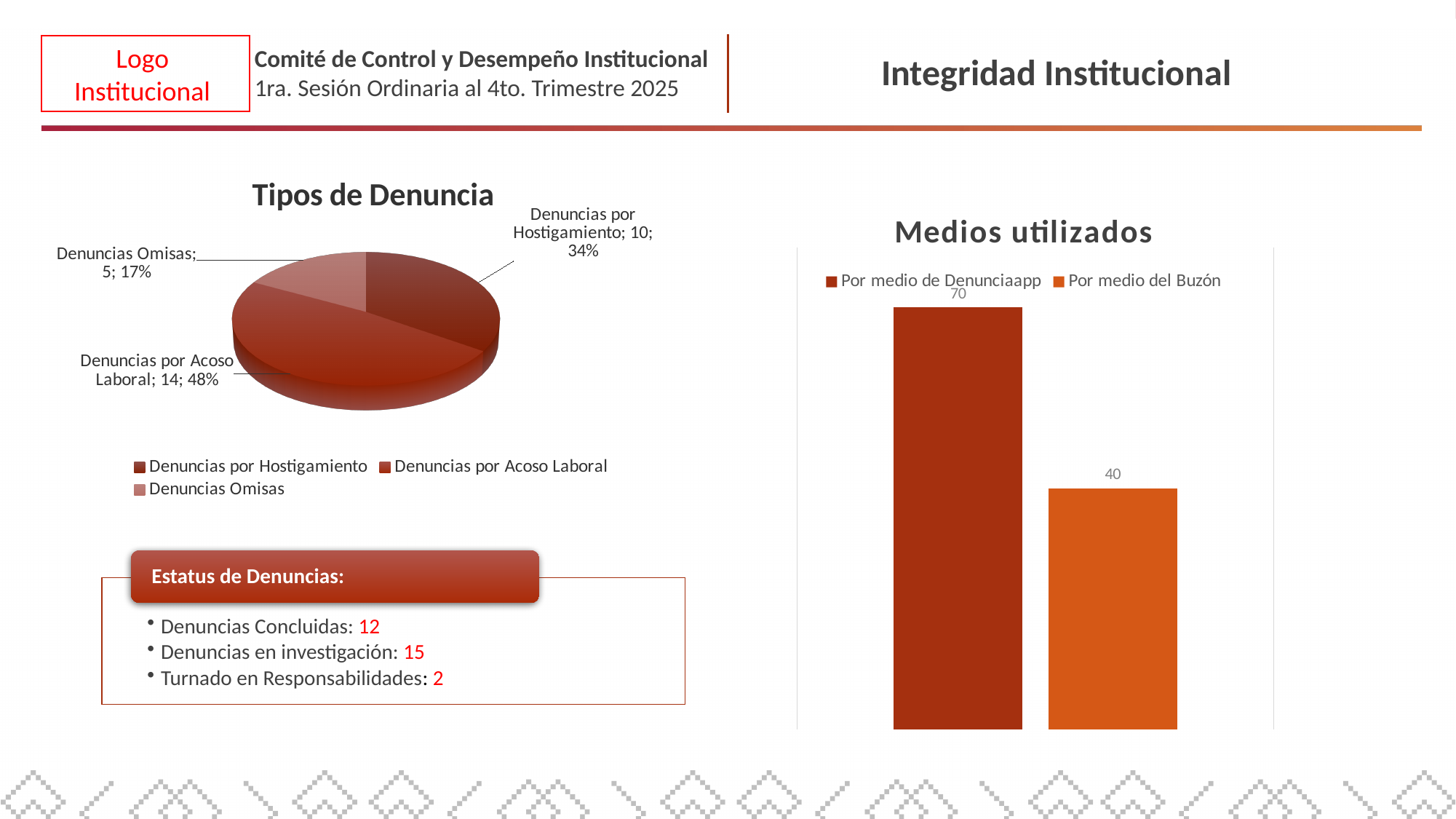
In the 'Tipos de Denuncia' chart, how many denuncias are 'Denuncias por Acoso Laboral'? 14 How many series does the legend of the 'Medios utilizados' chart list? 2 In the 'Tipos de Denuncia' chart, what percentage share do 'Denuncias por Hostigamiento' have? 34% In the 'Tipos de Denuncia' chart, which category has the smallest slice? Denuncias Omisas In the 'Tipos de Denuncia' chart, which category has the largest slice? Denuncias por Acoso Laboral In the 'Tipos de Denuncia' chart, what is the difference between the counts for 'Denuncias por Acoso Laboral' and 'Denuncias Omisas'? 9 What kind of chart is 'Tipos de Denuncia'? Pie chart In the 'Medios utilizados' chart, what is the value for 'Por medio del Buzón'? 40 In the 'Medios utilizados' chart, what is the difference between 'Por medio de Denunciaapp' and 'Por medio del Buzón'? 30 How many categories does the 'Tipos de Denuncia' chart show? 3 In the 'Medios utilizados' chart, what is the value for 'Por medio de Denunciaapp'? 70 What kind of chart is 'Medios utilizados'? Bar chart